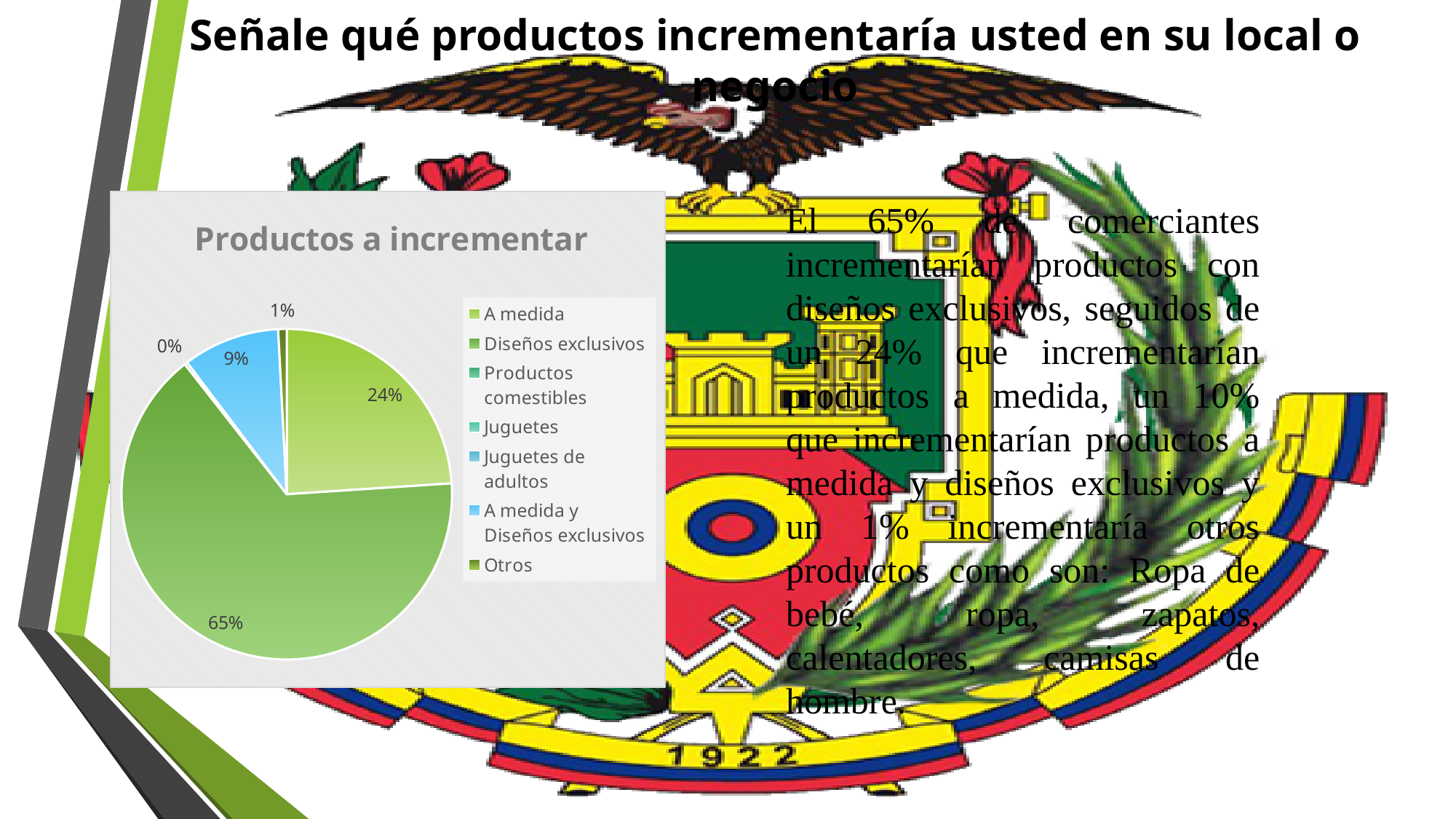
What is the difference in percentage points between A medida and A medida y Diseños exclusivos? 15 percentage points What is the difference in percentage points between Diseños exclusivos and A medida? 41 percentage points What type of chart is shown on the slide? Pie chart Which is larger, the slice for A medida or the slice for A medida y Diseños exclusivos? A medida What percentage does the A medida slice show? 24% What percentage is shown for Otros? 1% What is the title of the chart? Productos a incrementar What percentage is shown for A medida y Diseños exclusivos? 9% Which is larger, the slice for Otros or the slice for A medida y Diseños exclusivos? A medida y Diseños exclusivos What percentage of the pie chart is labelled for Diseños exclusivos? 65% How many categories does the legend of the pie chart list? 7 Which category has the largest slice of the pie chart? Diseños exclusivos